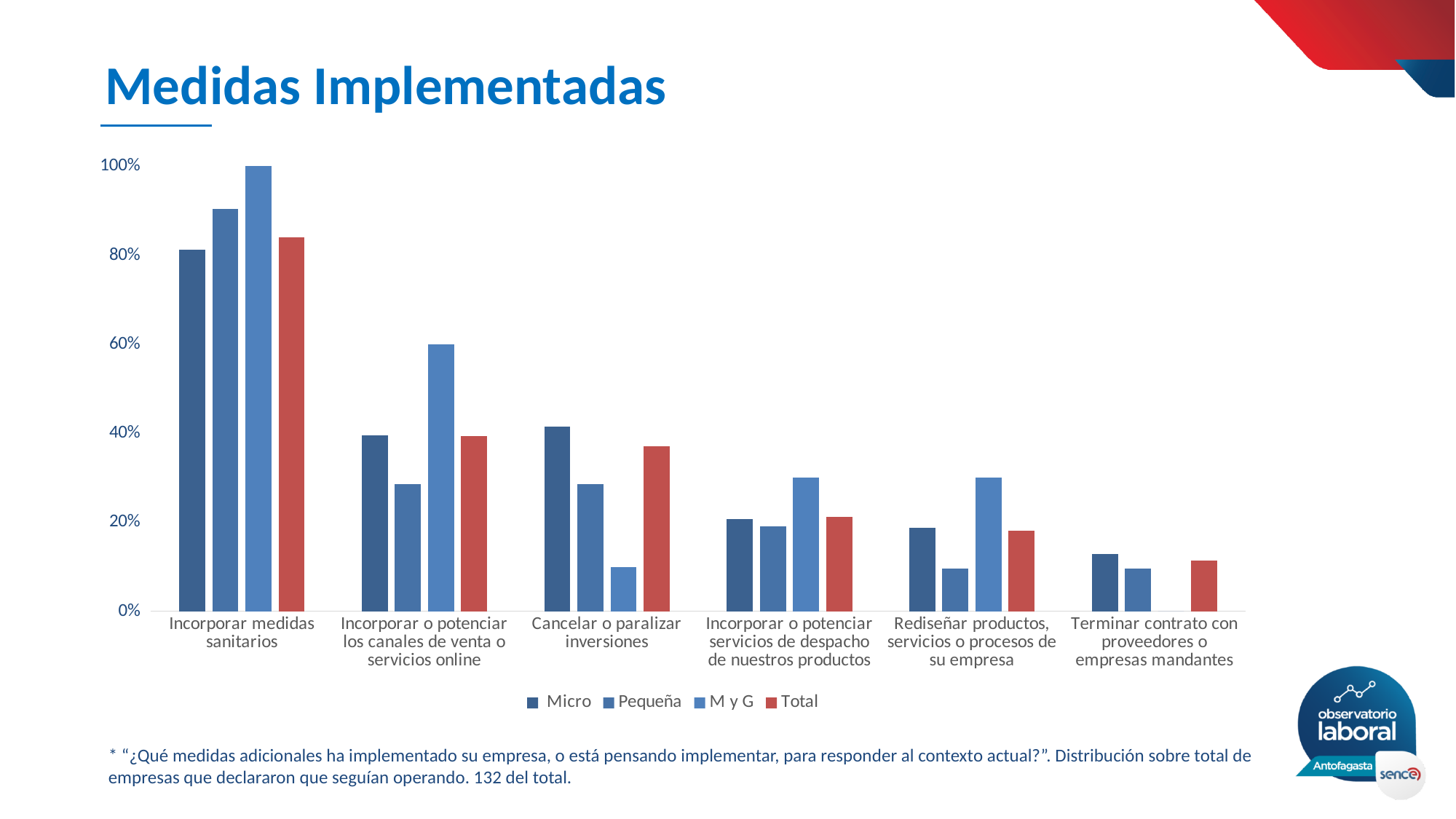
Which category has the lowest Total value? Terminar contrato con proveedores o empresas mandantes Is the Pequeña value for 'Incorporar medidas sanitarios' greater or less than 80%? greater For 'Cancelar o paralizar inversiones', which is larger: the Micro value or the Pequeña value? Micro Which series has the highest bar for 'Incorporar medidas sanitarios'? M y G How many series does the legend list? 4 Do the Total values rise or fall moving from left to right across the categories? fall What kind of chart is shown on the slide? bar chart Is the Total value for 'Terminar contrato con proveedores o empresas mandantes' greater or less than 20%? less Which category has the highest Total value? Incorporar medidas sanitarios Is the M y G value for 'Cancelar o paralizar inversiones' greater or less than 20%? less What is the value of the M y G bar for 'Incorporar medidas sanitarios'? 100% How many measure categories are shown along the x axis? 6